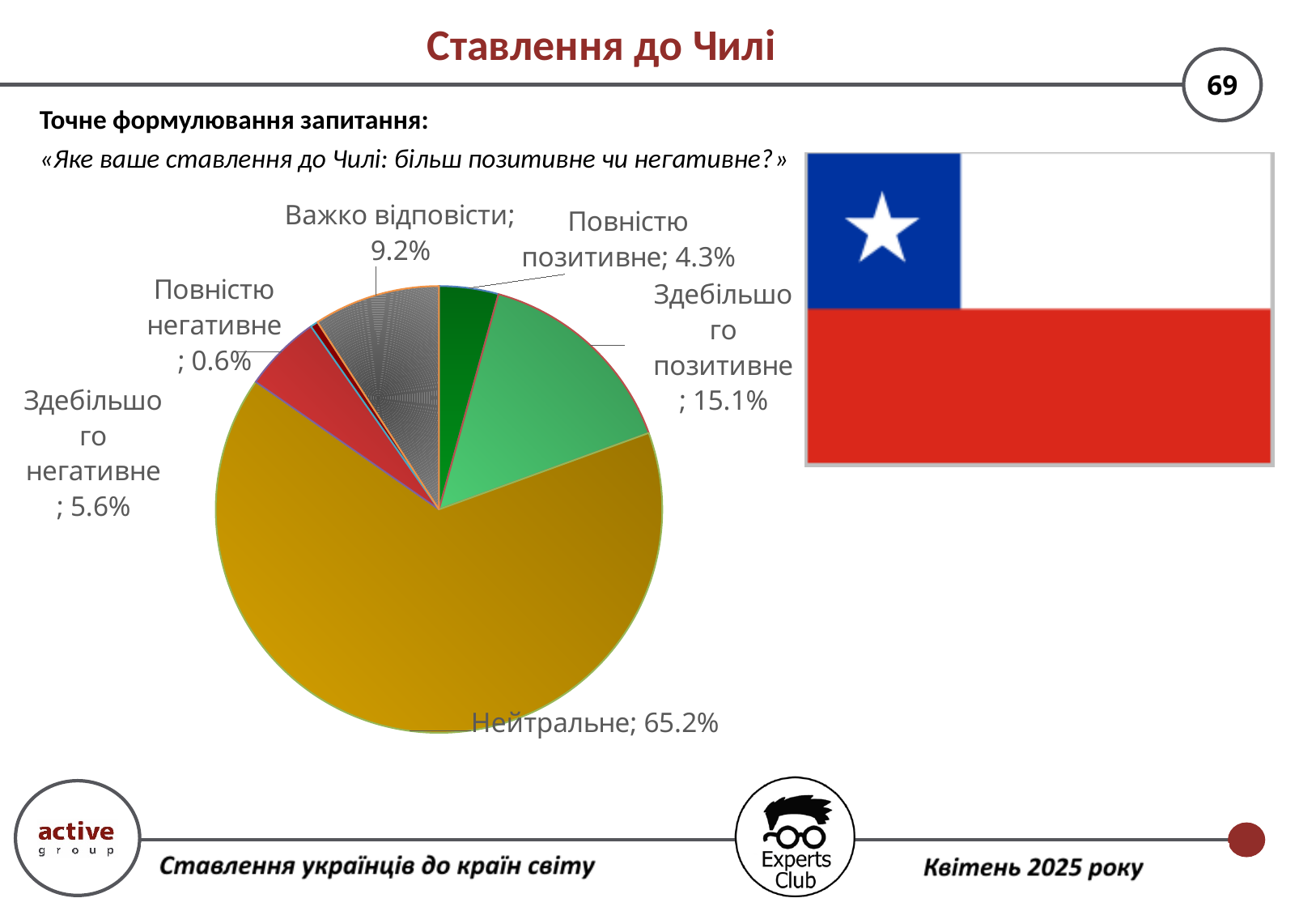
What share of respondents answered 'Здебільшого позитивне'? 15.1% What share of respondents answered 'Нейтральне' in the pie chart? 65.2% What share of respondents answered 'Повністю негативне'? 0.6% Which category has the largest slice of the pie chart? Нейтральне Which is larger: the share for 'Повністю позитивне' or for 'Здебільшого негативне'? Здебільшого негативне What is the title of the slide containing the chart? Ставлення до Чилі What is the difference between the shares for 'Здебільшого позитивне' and 'Здебільшого негативне'? 9.5% What share of respondents answered 'Важко відповісти'? 9.2% What type of chart is shown on the slide? Pie chart Which category has the smallest slice of the pie chart? Повністю негативне What is the combined share of 'Повністю позитивне' and 'Здебільшого позитивне'? 19.4% How many categories are shown in the pie chart? 6